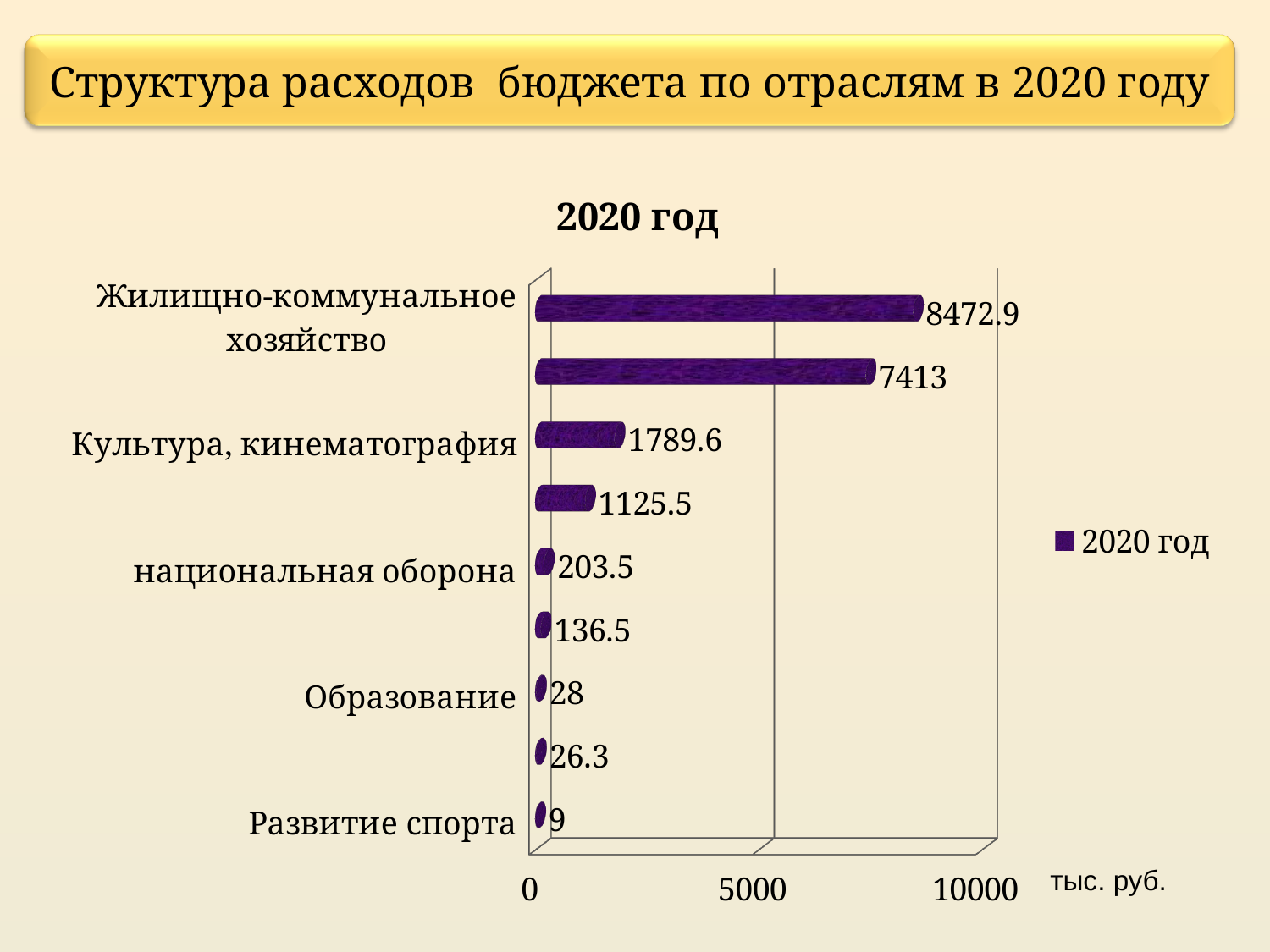
What is the value for Образование? 28 Which category has the lowest value? Развитие спорта What is the value for Культура, кинематография? 1789.6 Is the value for Жилищно-коммунальное хозяйство greater or less than 5000? greater What is the value for Развитие спорта? 9 What is the difference between the values for Жилищно-коммунальное хозяйство and Культура, кинематография? 6683.3 Which category has the highest value? Жилищно-коммунальное хозяйство What is the value for Жилищно-коммунальное хозяйство? 8472.9 How many bars are plotted in the chart? 9 What kind of chart is shown on the slide? bar chart Which is larger, the value for национальная оборона or the value for Образование? национальная оборона What is the value for национальная оборона? 203.5